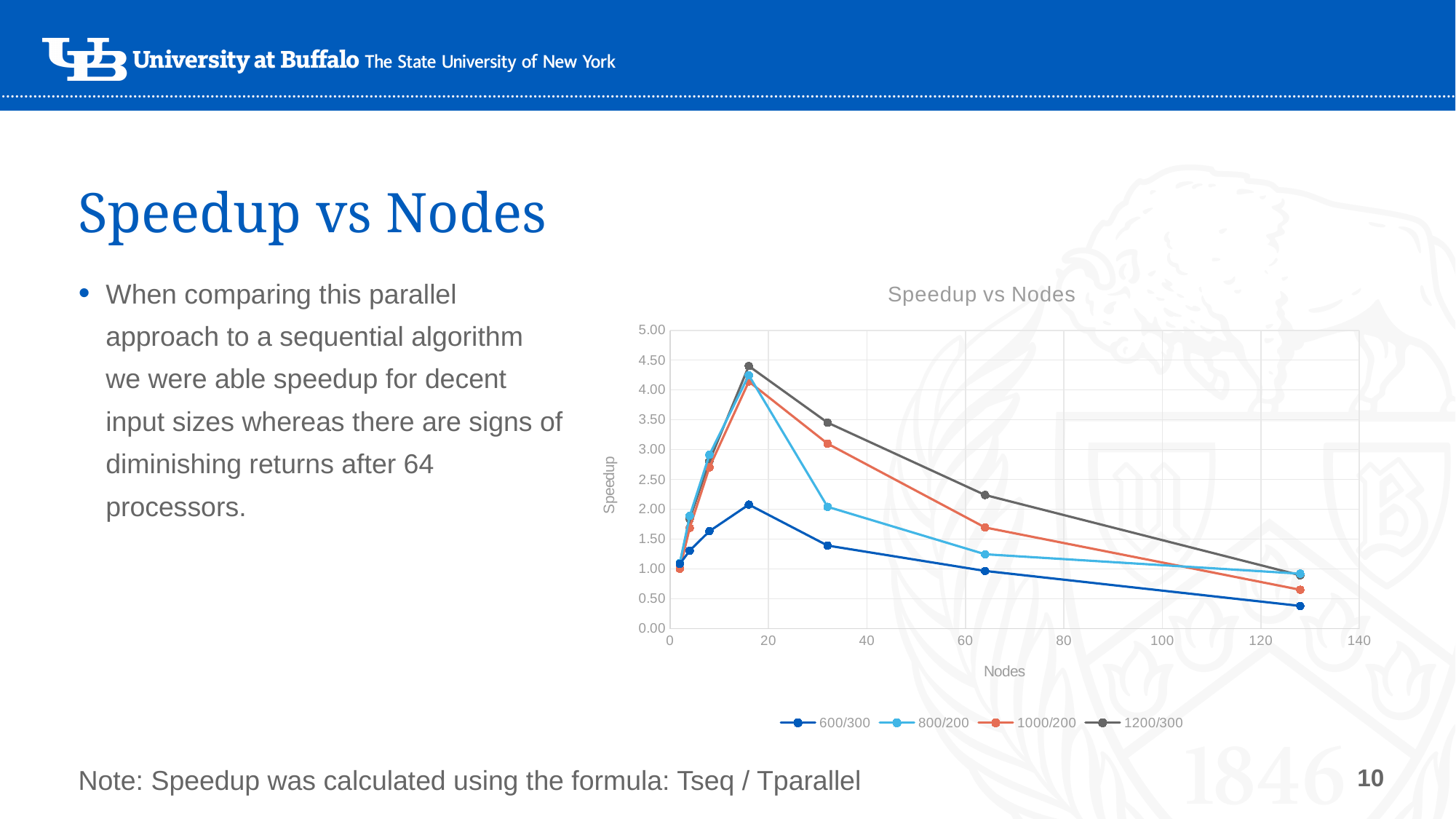
Is the speedup of the 1200/300 series at 64 nodes greater or less than 2.00? greater How many series does the chart legend list? 4 Which series reaches the highest speedup on the chart? 1200/300 What is the label of the chart's y axis? Speedup Is the peak speedup of the 1200/300 series greater or less than 4.00? greater Which series has the lowest speedup at 128 nodes? 600/300 Do the speedup values rise or fall as nodes increase from 16 to 128? fall What kind of chart is shown on the slide? line chart How many data points are plotted for the 1200/300 series? 7 At 128 nodes, which series has the larger speedup, 800/200 or 1000/200? 800/200 Is the speedup of the 600/300 series at 128 nodes greater or less than 0.50? less At 64 nodes, which series has the larger speedup, 1200/300 or 600/300? 1200/300